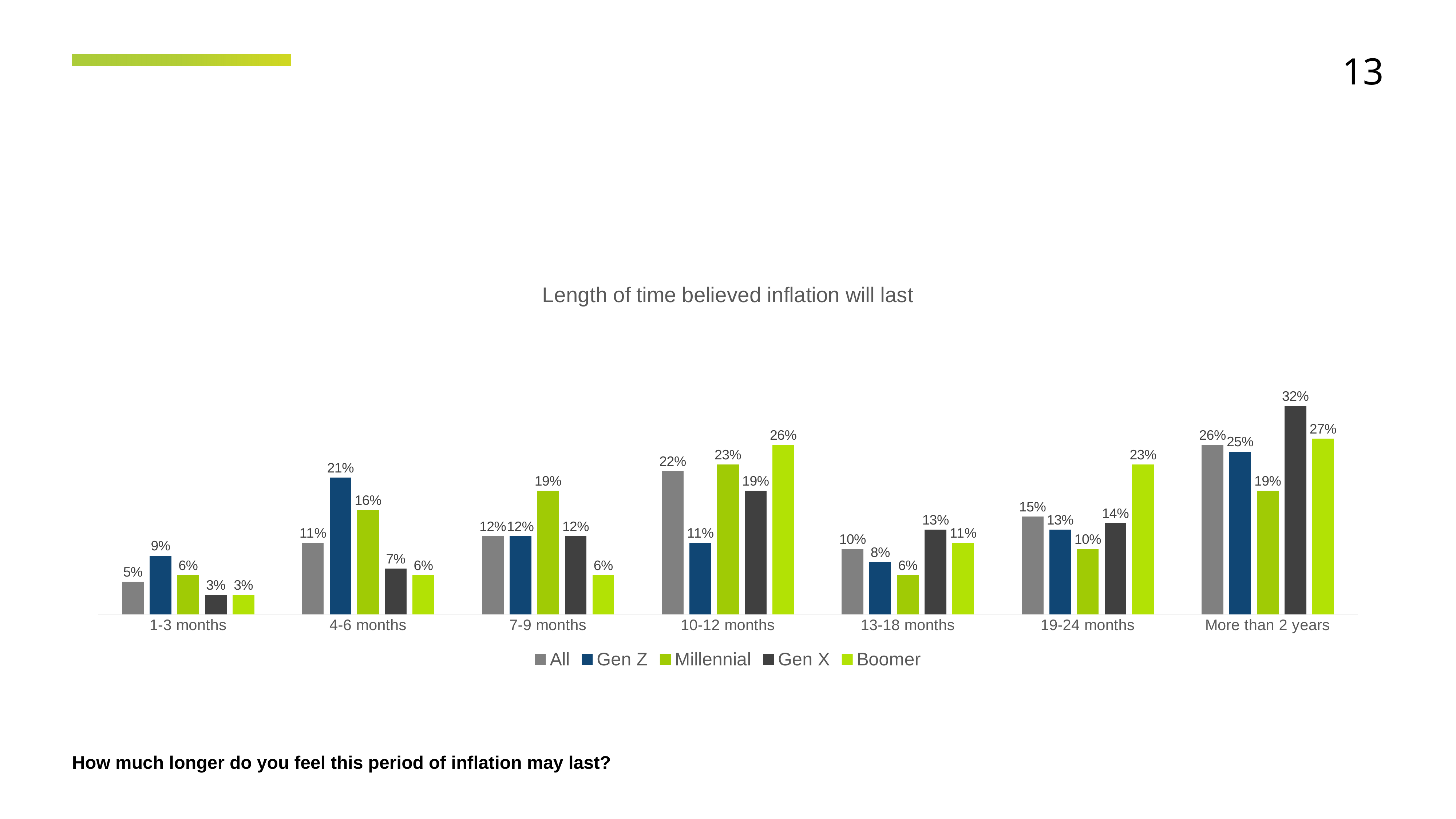
How many series does the legend list? 5 Which category has the highest value for the All series? More than 2 years What is the title of the chart? Length of time believed inflation will last Which is larger in the 7-9 months category: Millennial or Boomer? Millennial Which category has the lowest value for the Gen Z series? 13-18 months What is the difference between the Gen X and Millennial values in the More than 2 years category? 13% What is the value for Boomer in the 10-12 months category? 26% What is the value for Gen Z in the 4-6 months category? 21% What kind of chart is shown on the slide? Bar chart What is the value for Gen X in the More than 2 years category? 32% What is the value for Millennial in the 13-18 months category? 6% How many categories are shown on the x axis? 7